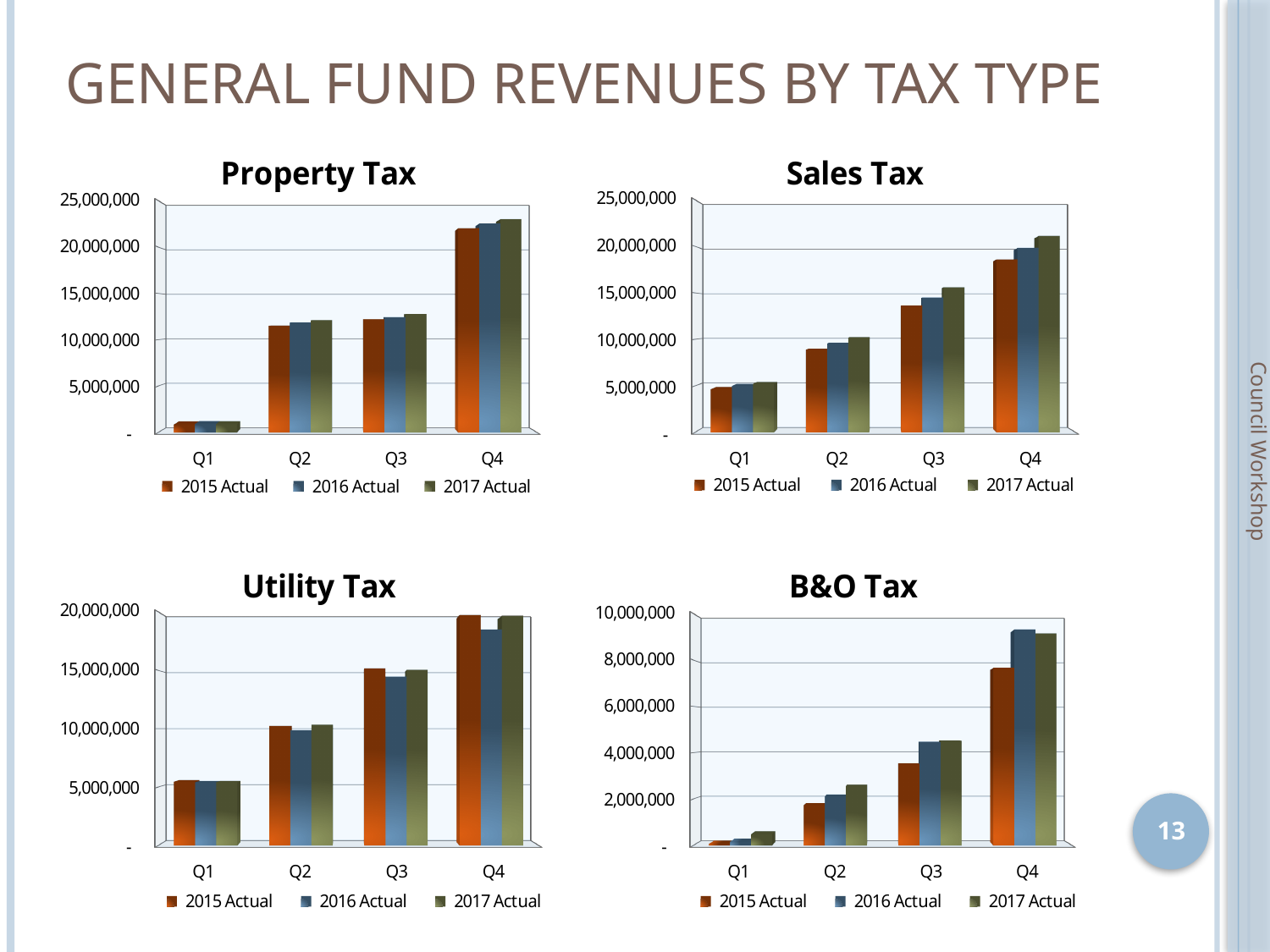
In the Property Tax chart, which quarter has the highest values? Q4 What is the title of the chart in the bottom-right of the slide? B&O Tax In the Sales Tax chart, is the value for 2017 Actual in Q4 greater or less than 20,000,000? greater What kind of chart is the Property Tax chart? bar chart In the B&O Tax chart, which is larger in Q3: 2015 Actual or 2016 Actual? 2016 Actual In the Utility Tax chart, which is larger in Q4: 2015 Actual or 2016 Actual? 2015 Actual In the Sales Tax chart, is the value for 2015 Actual in Q2 greater or less than 10,000,000? less In the B&O Tax chart, is the value for 2016 Actual in Q4 greater or less than 8,000,000? greater In the Sales Tax chart, do the values rise or fall from Q1 to Q4? rise How many series does the legend of the Sales Tax chart list? 3 How many quarters are shown on the x axis of the Utility Tax chart? 4 In the Sales Tax chart, which quarter has the lowest values? Q1